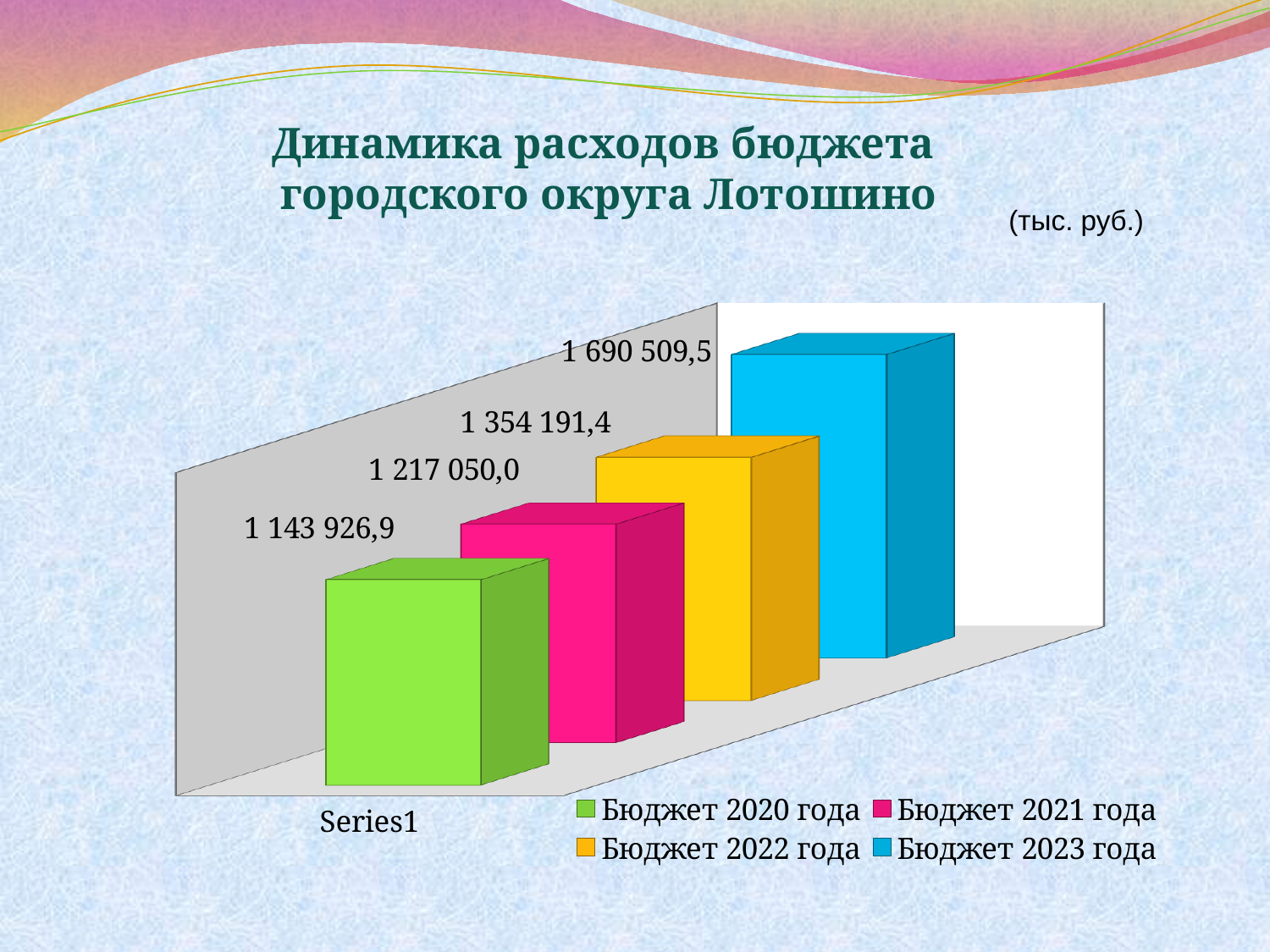
What is the value for Бюджет 2023 года? 1 690 509,5 What is the value for Бюджет 2022 года? 1 354 191,4 What is the value for Бюджет 2021 года? 1 217 050,0 What kind of chart is shown on the slide? Bar chart Which budget year has the highest value? Бюджет 2023 года What is the value for Бюджет 2020 года? 1 143 926,9 Which budget year has the lowest value? Бюджет 2020 года Which is larger, the value for Бюджет 2022 года or Бюджет 2021 года? Бюджет 2022 года What is the difference between the values for Бюджет 2021 года and Бюджет 2020 года? 73 123,1 What is the difference between the values for Бюджет 2023 года and Бюджет 2022 года? 336 318,1 What unit is stated for the values on the chart? тыс. руб. How many series does the legend list? 4